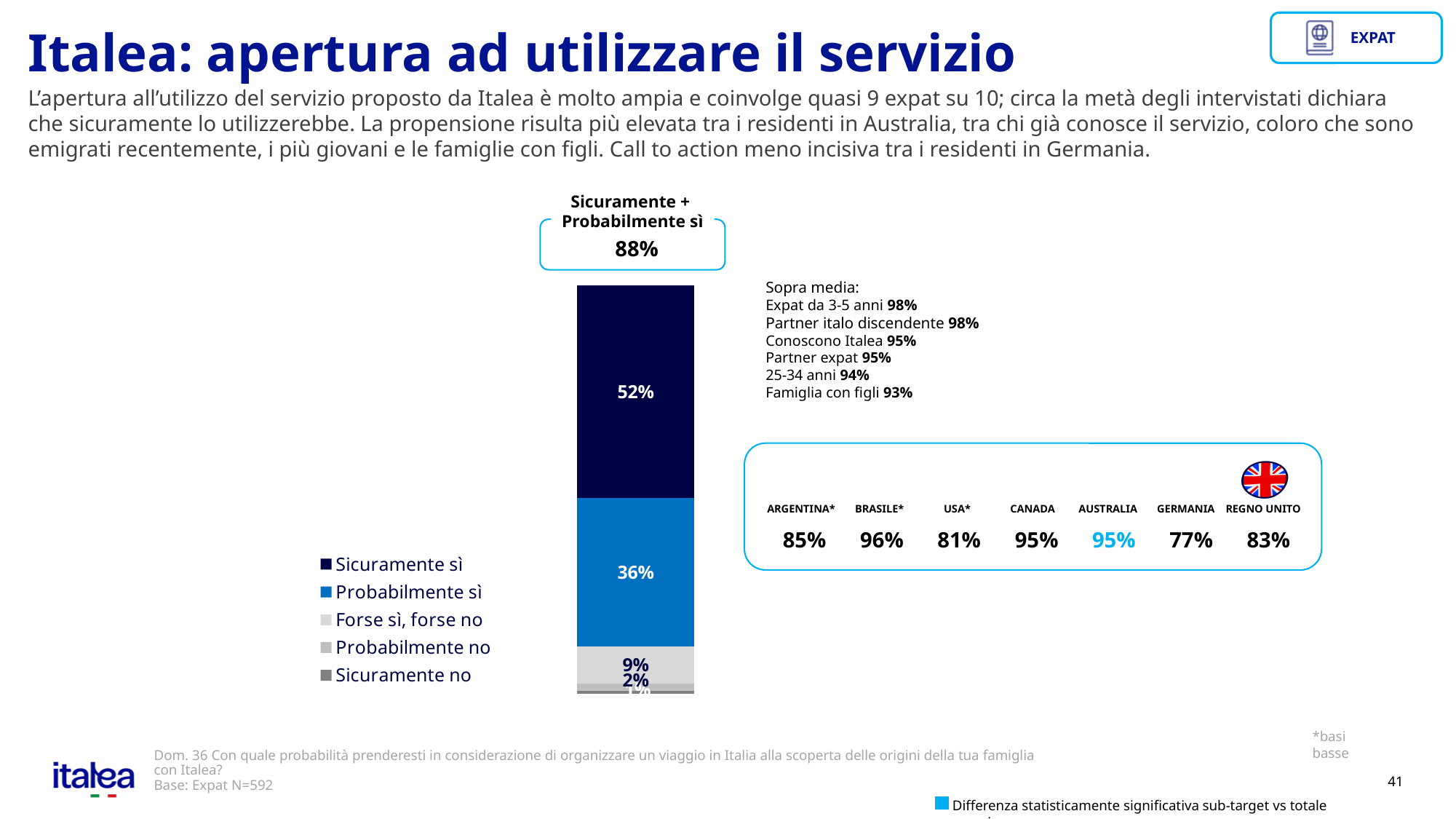
What is the value for "Sicuramente sì" in the stacked bar? 52% What kind of chart is shown on the slide? stacked bar chart What is the difference between the "Forse sì, forse no" and "Probabilmente no" values? 7% Which segment of the stacked bar has the largest value? Sicuramente sì How many series does the chart legend list? 5 What is the combined value of "Sicuramente sì" and "Probabilmente sì" shown in the callout above the bar? 88% What is the value for "Probabilmente sì" in the stacked bar? 36% Which legend entry is shown in the darkest navy colour? Sicuramente sì What is the value for "Probabilmente no" in the stacked bar? 2% What is the value for "Forse sì, forse no" in the stacked bar? 9% Which is larger, the "Probabilmente sì" value or the "Forse sì, forse no" value? Probabilmente sì What is the difference between the "Sicuramente sì" and "Probabilmente sì" values? 16%